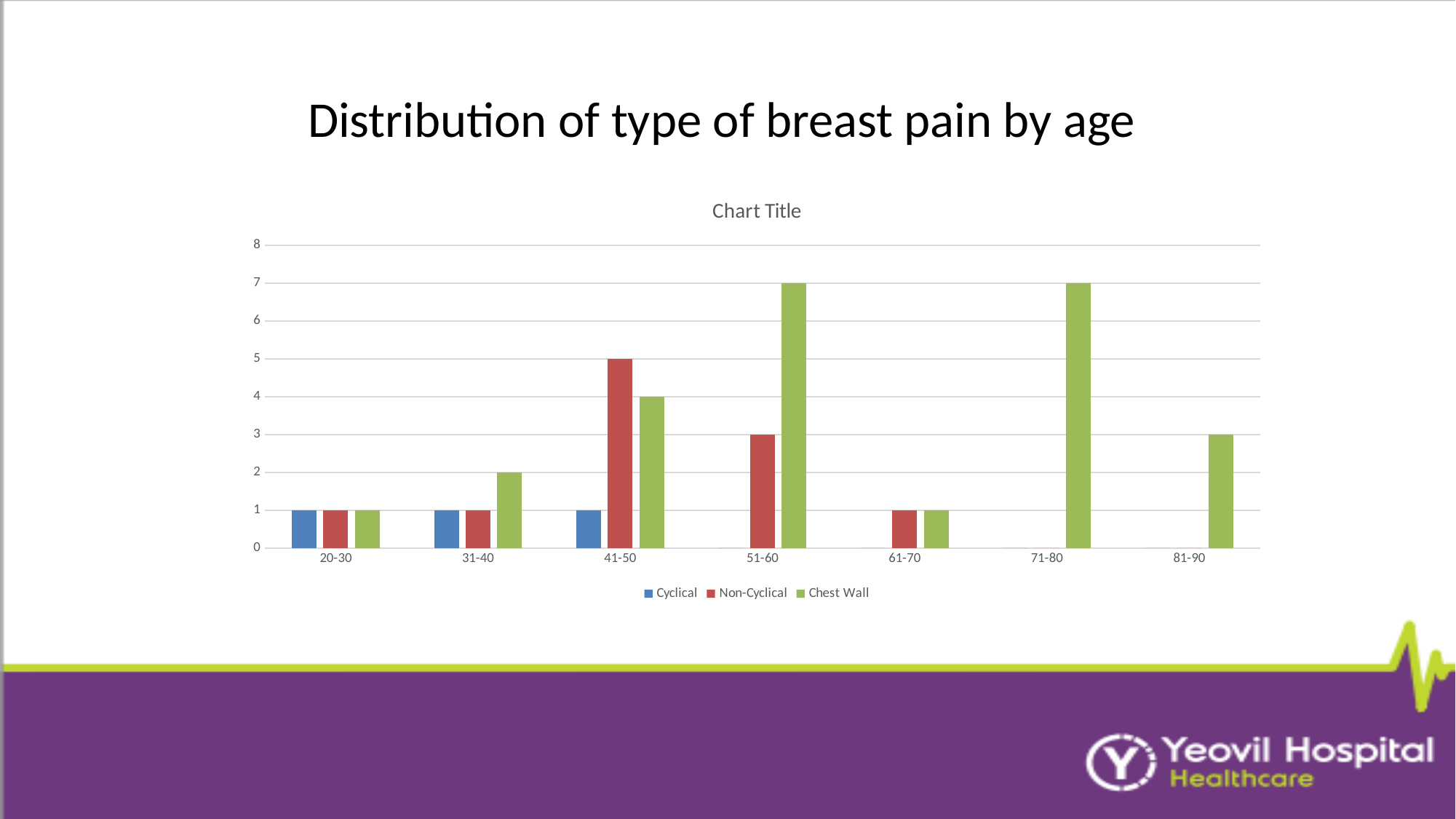
How many age categories are shown on the x axis? 7 How many series does the legend list? 3 For the 51-60 age group, which is larger: the Non-Cyclical value or the Chest Wall value? Chest Wall What type of chart is shown on the slide? Bar chart What is the Non-Cyclical value for the 41-50 age group? 5 What is the difference between the Non-Cyclical and Chest Wall values for the 41-50 age group? 1 What is the Chest Wall value for the 81-90 age group? 3 What is the Non-Cyclical value for the 51-60 age group? 3 Is the Chest Wall value for the 71-80 age group greater or less than 5? greater Which age group has the highest Non-Cyclical value? 41-50 Which colour represents the Chest Wall series in the legend? Green What is the Chest Wall value for the 51-60 age group? 7